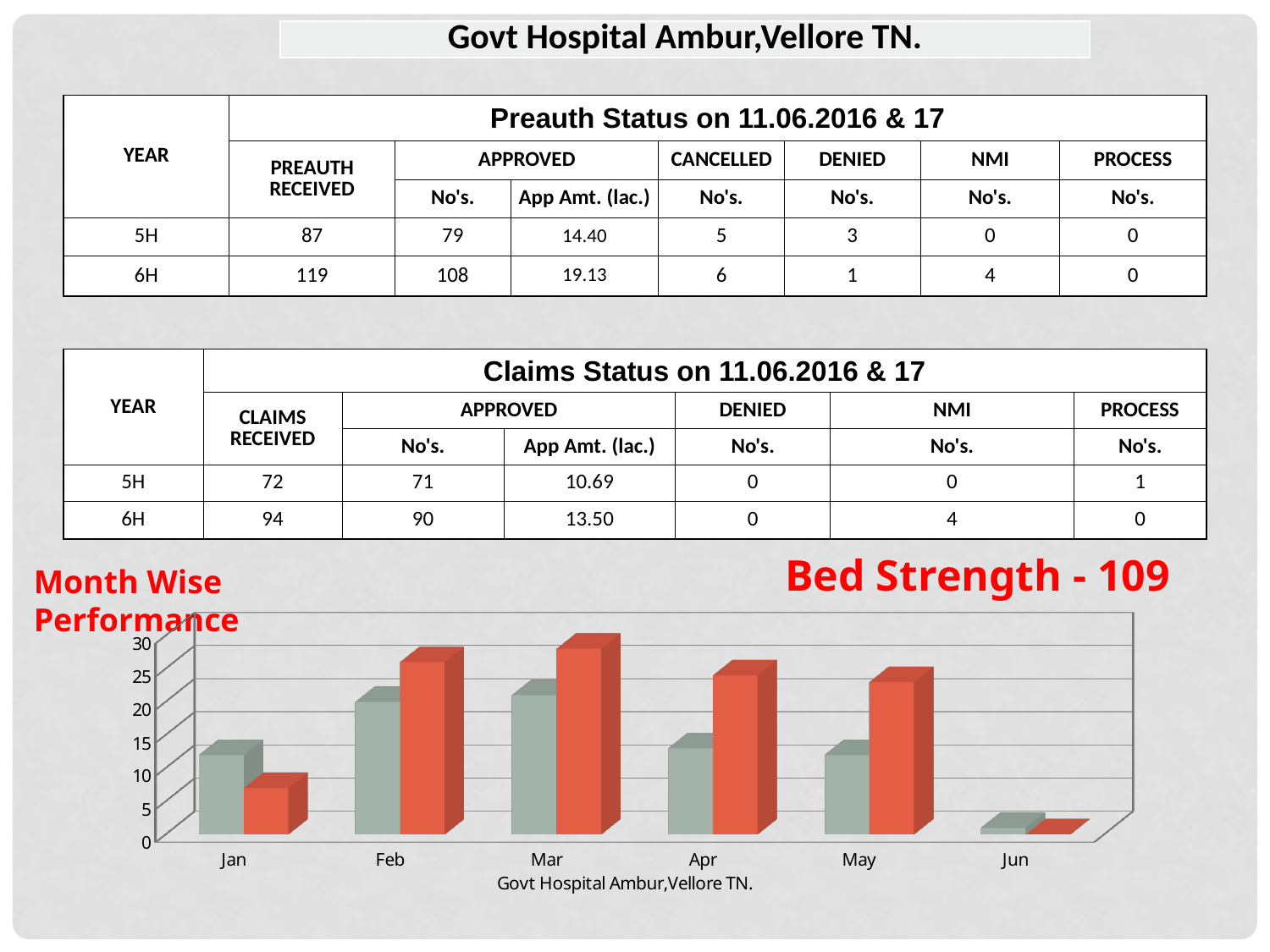
In the Month Wise Performance chart, is the grey bar for Feb greater or less than 15? greater In the Month Wise Performance chart, is the red bar for Jan greater or less than 10? less In the Month Wise Performance chart, which bar is taller for Apr, the grey one or the red one? the red one In the Month Wise Performance chart, do the red bars rise or fall from Mar to Jun? fall How many months are shown on the x axis of the Month Wise Performance chart? 6 What title is printed beneath the x axis of the Month Wise Performance chart? Govt Hospital Ambur,Vellore TN. In the Month Wise Performance chart, is the red bar for Feb greater or less than 20? greater In the Month Wise Performance chart, in which month is the red bar the tallest? Mar In the Month Wise Performance chart, which month has the lowest bars for both series? Jun What kind of chart is shown under the 'Month Wise Performance' heading? bar chart In the Month Wise Performance chart, which bar is taller for Jan, the grey one or the red one? the grey one